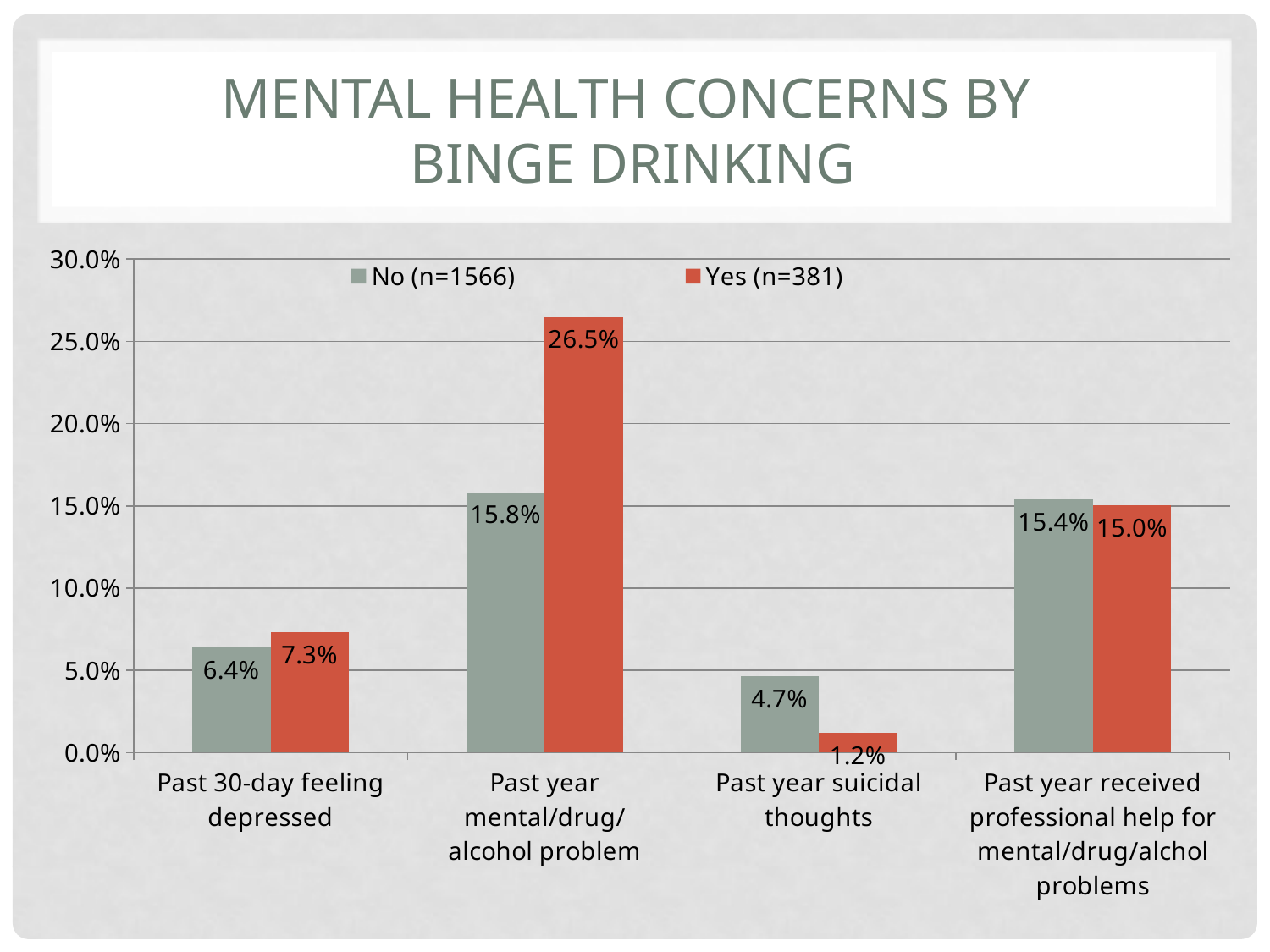
Is the 'Yes (n=381)' value for 'Past year mental/drug/alcohol problem' greater or less than 25.0%? greater What kind of chart is shown on the slide? bar chart What is the value for 'Yes (n=381)' for 'Past 30-day feeling depressed'? 7.3% How many categories are shown on the x axis? 4 What is the value for 'No (n=1566)' for 'Past year received professional help for mental/drug/alchol problems'? 15.4% For 'Past year suicidal thoughts', which series has the larger value, 'No (n=1566)' or 'Yes (n=381)'? No (n=1566) What is the difference between the 'Yes (n=381)' and 'No (n=1566)' values for 'Past year mental/drug/alcohol problem'? 10.7% Which category has the lowest value for the 'Yes (n=381)' series? Past year suicidal thoughts Which category has the highest value for the 'Yes (n=381)' series? Past year mental/drug/alcohol problem What is the value for 'Yes (n=381)' for 'Past year mental/drug/alcohol problem'? 26.5% How many series does the legend list? 2 What is the value for 'No (n=1566)' for 'Past year suicidal thoughts'? 4.7%